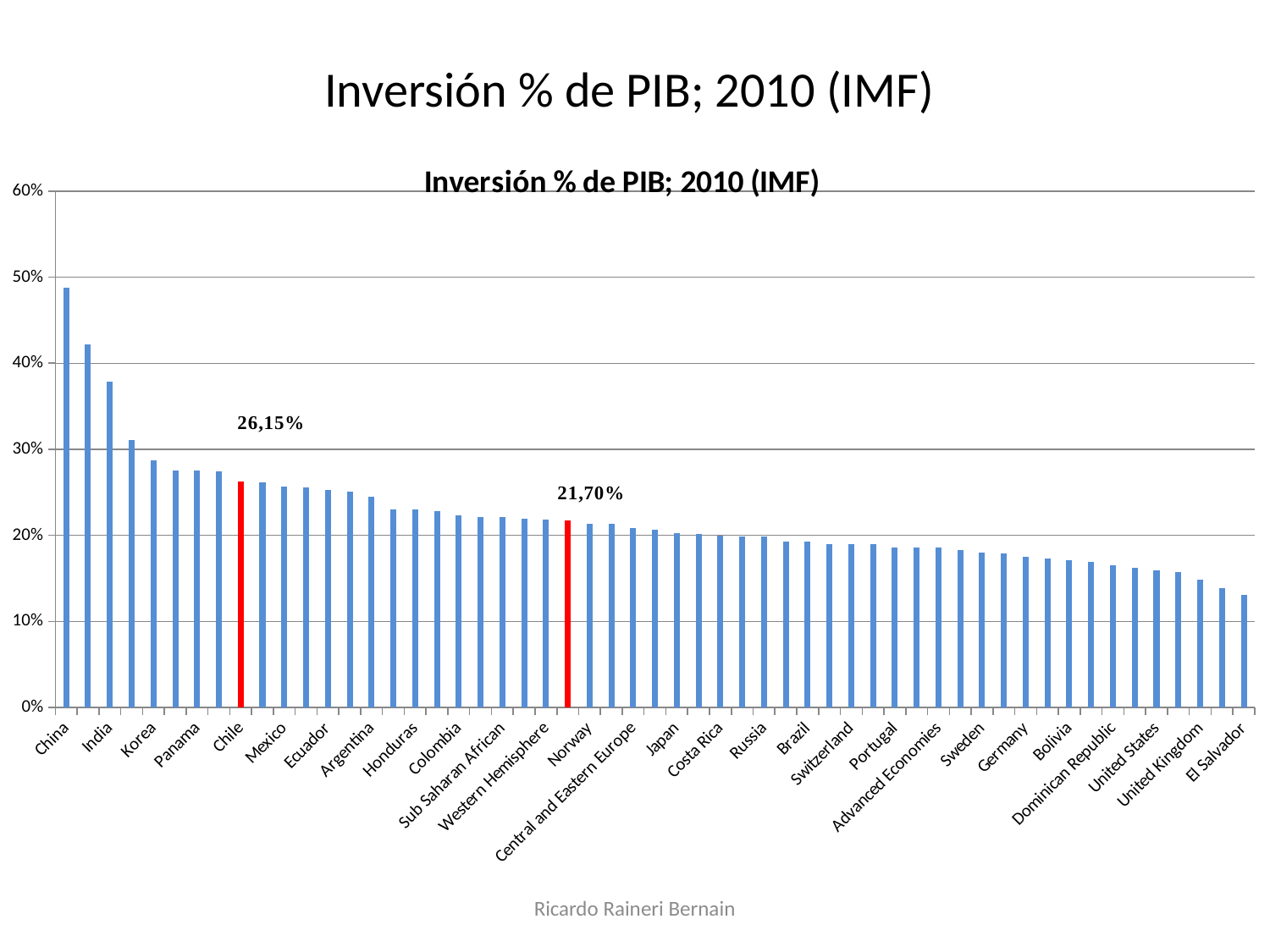
Is the value for China greater or less than 40%? greater Which category has the lowest value on the chart? El Salvador What kind of chart is shown on the slide? bar chart Which is larger, the value for Chile or the value for Norway? Chile Is the value for El Salvador greater or less than 20%? less Which country has the highest investment as % of GDP? China Do the values rise or fall from left to right along the x axis? fall Is the value for Korea greater or less than 30%? less